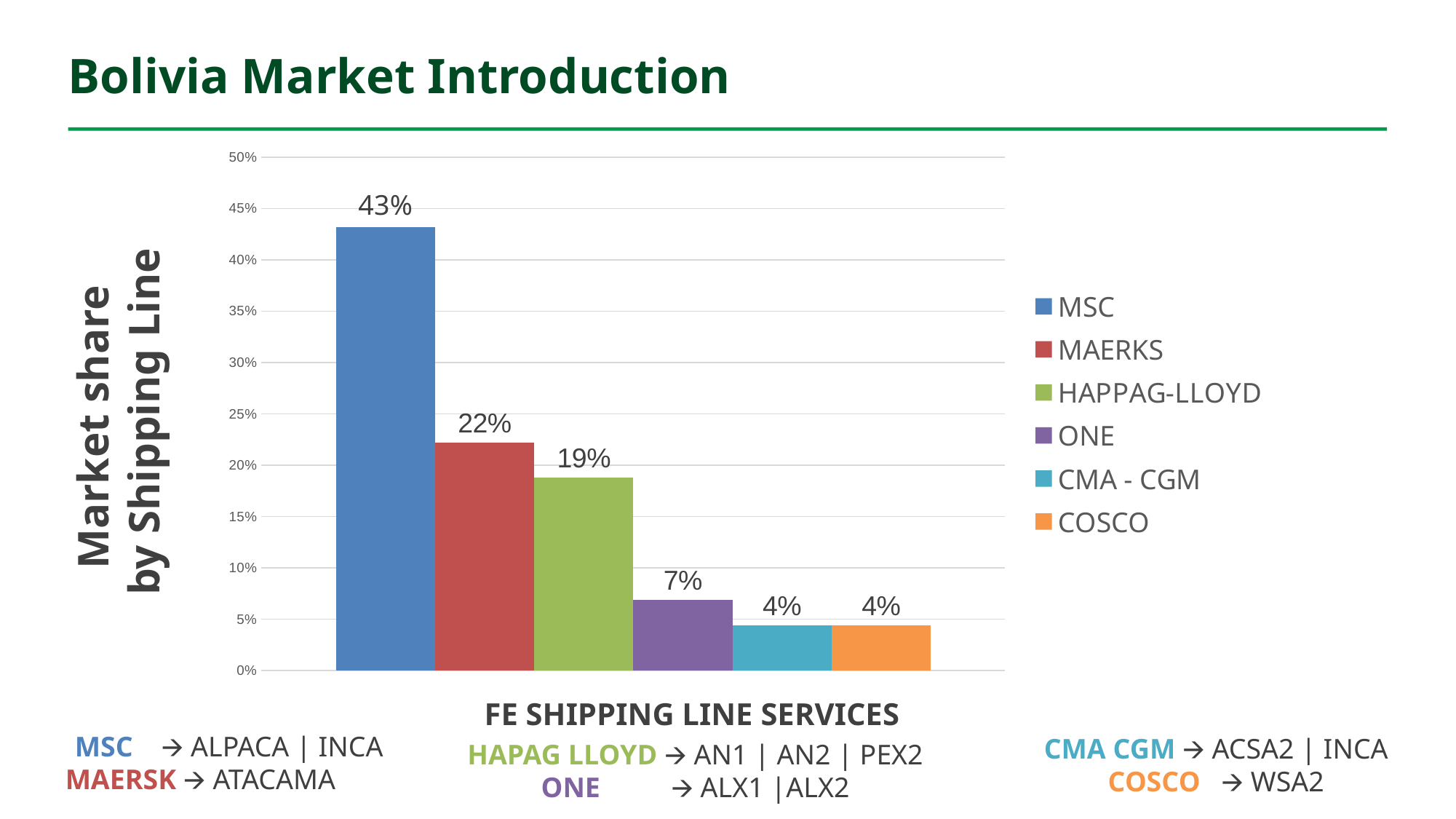
What is the market share for MSC? 43% What is the difference in market share between MSC and MAERKS? 21% Which has a larger market share, MAERKS or HAPPAG-LLOYD? MAERKS What is the difference in market share between HAPPAG-LLOYD and ONE? 12% Is the value for MSC greater or less than 40%? greater What is the market share for MAERKS? 22% What is the market share for ONE? 7% How many shipping lines are shown in the chart? 6 What is the market share for HAPPAG-LLOYD? 19% Which shipping line has the highest market share? MSC What is the title of the chart's x axis? FE SHIPPING LINE SERVICES What kind of chart is shown on the slide? Bar chart